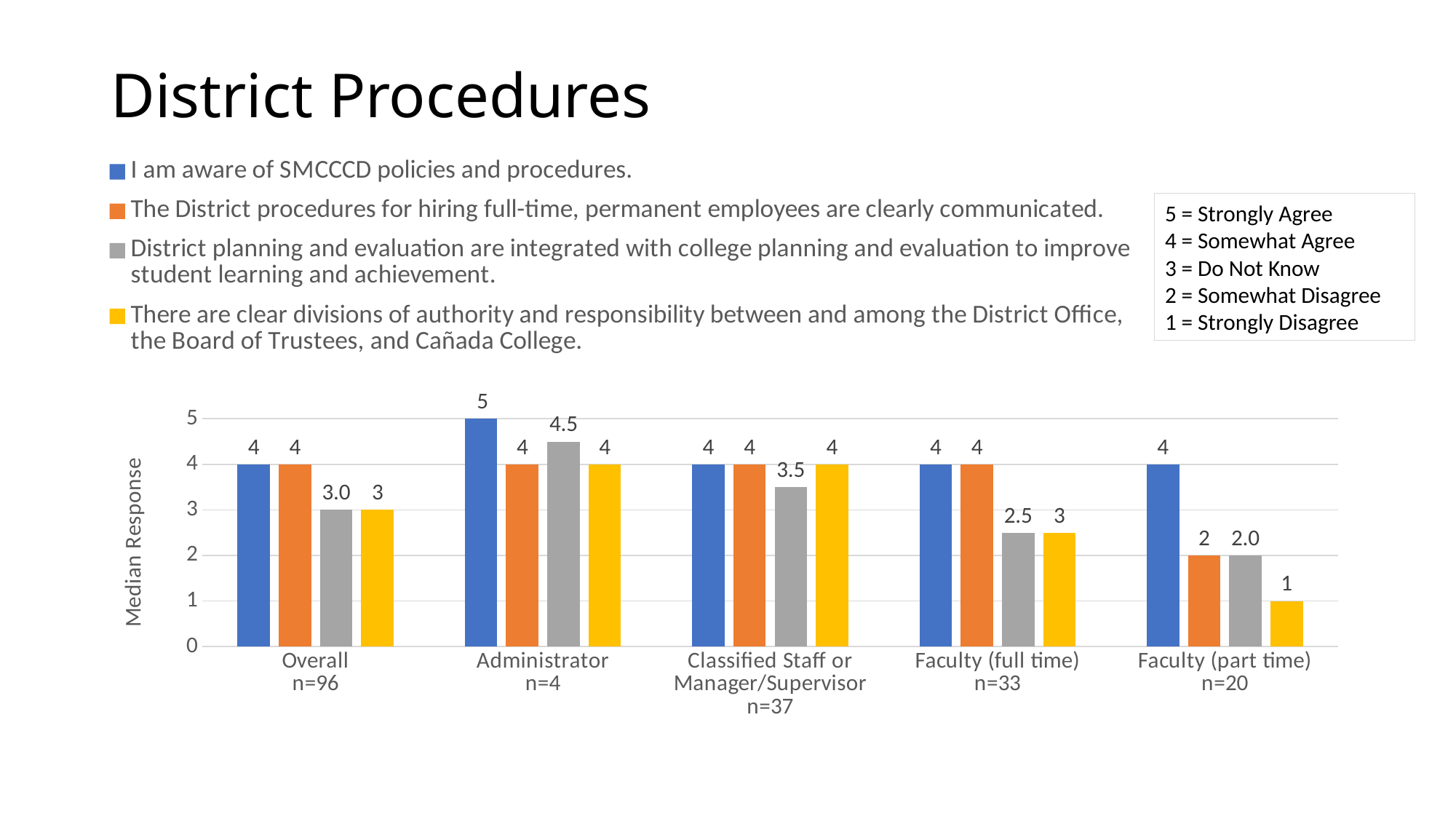
What kind of chart is shown on the slide? Bar chart Which group has the highest median response for 'I am aware of SMCCCD policies and procedures.'? Administrator For Faculty (part time), which is larger: the median response for 'I am aware of SMCCCD policies and procedures.' or for 'The District procedures for hiring full-time, permanent employees are clearly communicated.'? I am aware of SMCCCD policies and procedures. How many series does the chart's legend list? 4 What is the median response for Faculty (full time) on 'District planning and evaluation are integrated with college planning and evaluation to improve student learning and achievement.'? 2.5 Which group has the lowest median response for 'The District procedures for hiring full-time, permanent employees are clearly communicated.'? Faculty (part time) What is the median response for Administrator on 'I am aware of SMCCCD policies and procedures.'? 5 What is the difference between the Administrator and Faculty (part time) median responses for 'District planning and evaluation are integrated with college planning and evaluation to improve student learning and achievement.'? 2.5 What is the median response for Faculty (part time) on 'There are clear divisions of authority and responsibility between and among the District Office, the Board of Trustees, and Cañada College.'? 1 What is the median response for Classified Staff or Manager/Supervisor on 'District planning and evaluation are integrated with college planning and evaluation to improve student learning and achievement.'? 3.5 What is the label of the vertical axis of the chart? Median Response How many respondent groups are shown on the x axis of the chart? 5